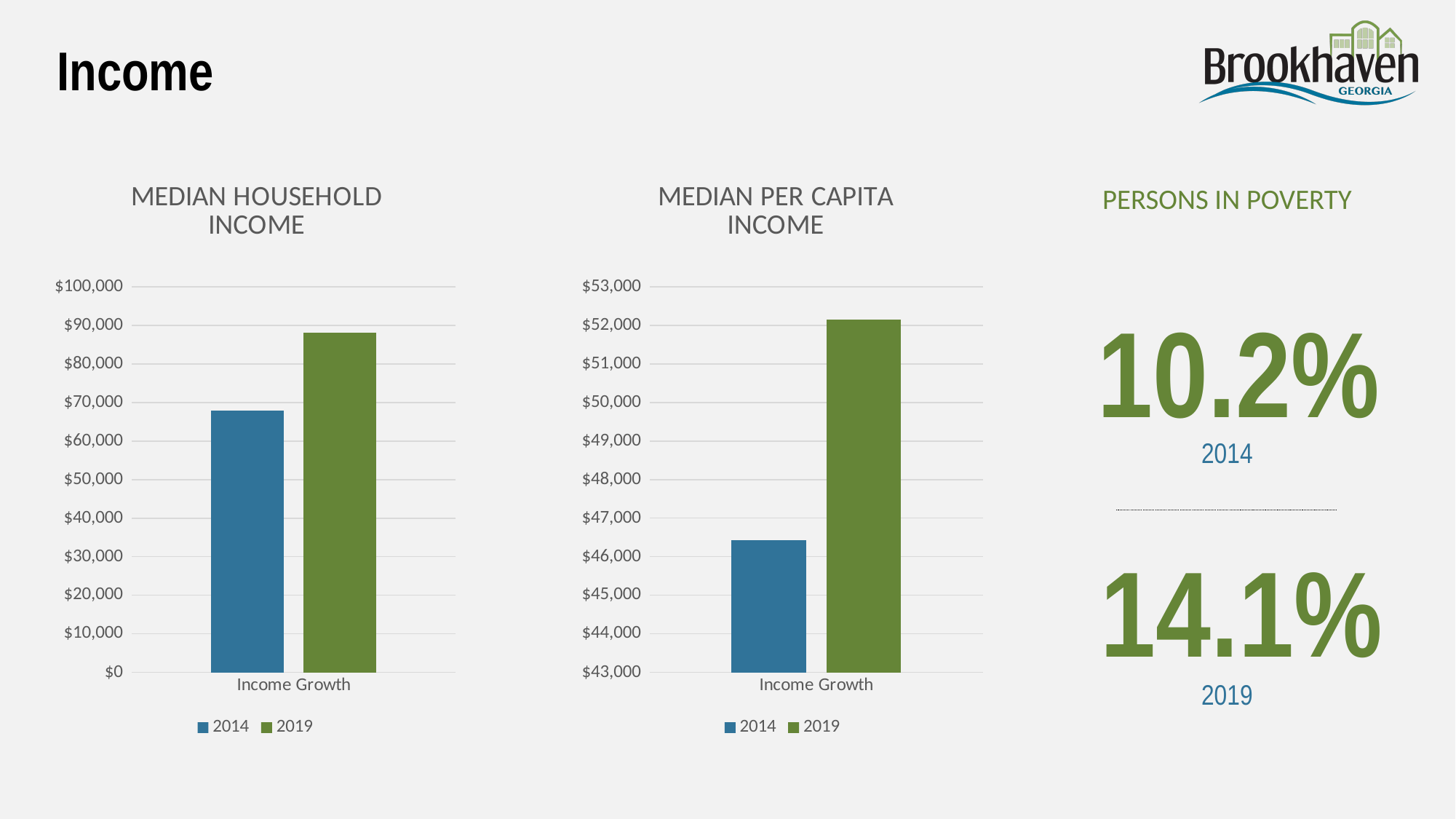
In the Median Household Income chart, is the value for 2014 greater or less than $70,000? less What kind of chart is the Median Per Capita Income chart? bar chart What colour is the 2019 series in the Median Household Income chart? green What is the category label on the x axis of the Median Per Capita Income chart? Income Growth In the Median Household Income chart, is the value for 2014 greater or less than $60,000? greater In the Median Household Income chart, is the value for 2019 greater or less than $90,000? less In the Median Household Income chart, which series has the taller bar, 2014 or 2019? 2019 In the Median Per Capita Income chart, which series has the lower bar, 2014 or 2019? 2014 What kind of chart is the Median Household Income chart? bar chart How many series does the legend of the Median Household Income chart list? 2